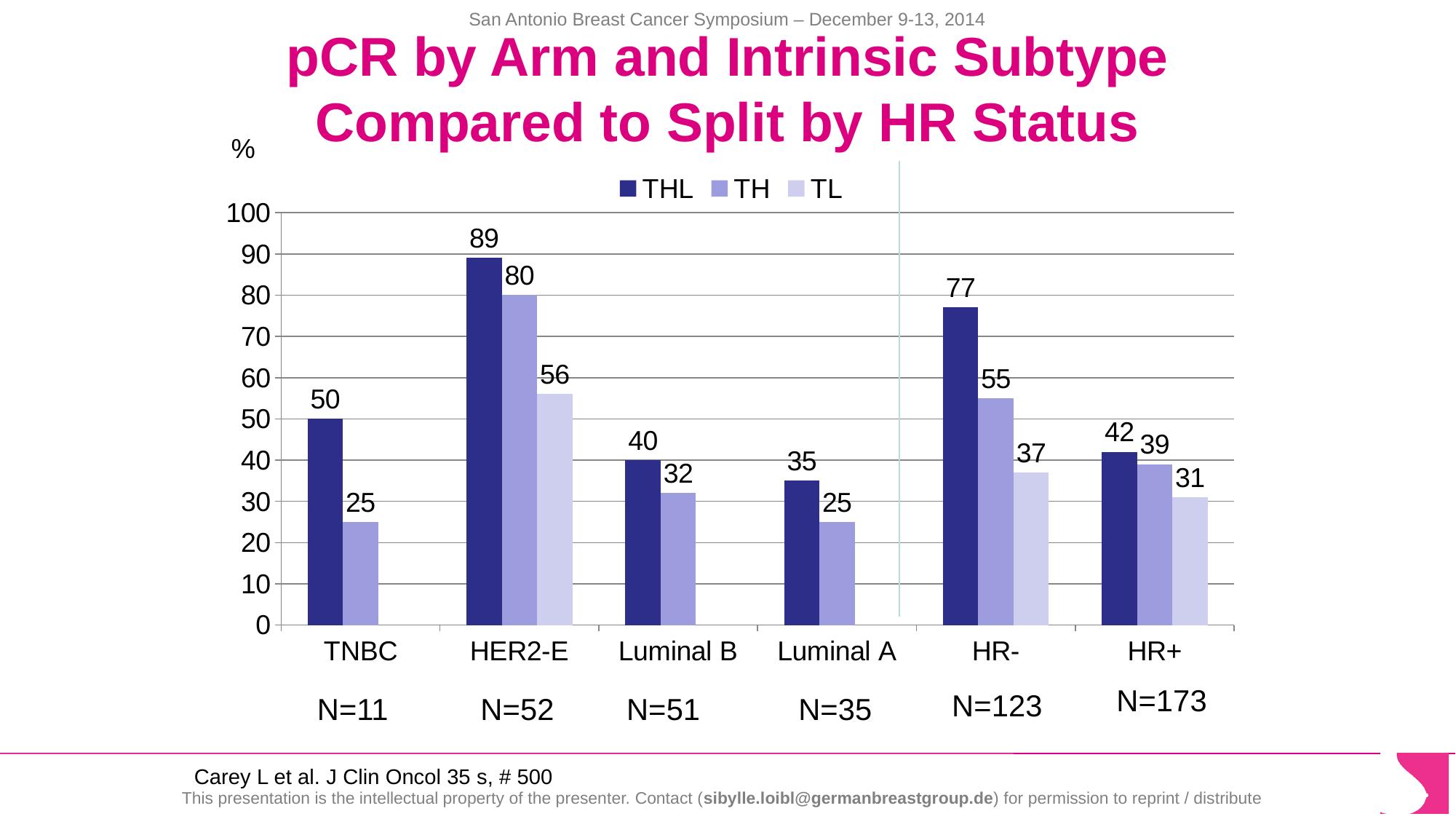
What is the difference between the TH and TL values for HR+? 8 How many series does the legend list? 3 What is the N shown under the HR+ category? N=173 Which is larger, the THL value for HR- or the THL value for HR+? HR- What is the difference between the THL and TH values for HER2-E? 9 How many categories are shown on the x axis? 6 What is the TL value for HR-? 37 What is the THL value for HER2-E? 89 What kind of chart is shown on the slide? Bar chart Which category has the highest THL value? HER2-E What is the TH value for TNBC? 25